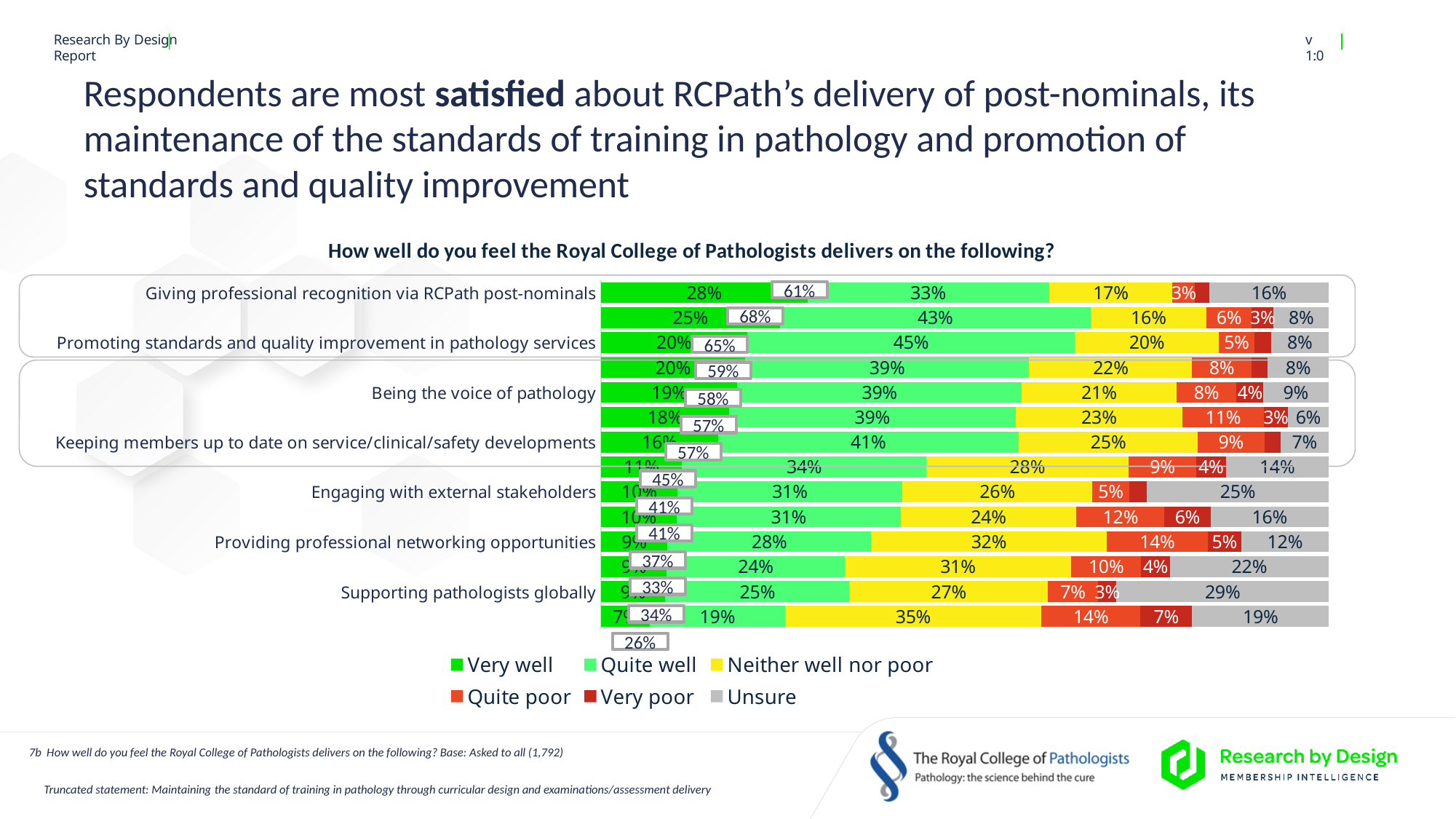
What is the 'Neither well nor poor' value for 'Being the voice of pathology'? 21% How many series does the legend list? 6 How many bars (statements) are plotted in the chart? 14 What kind of chart is shown on the slide? Stacked bar chart What is the 'Quite well' value for 'Promoting standards and quality improvement in pathology services'? 45% What is the 'Very well' value for 'Giving professional recognition via RCPath post-nominals'? 28% Which has the larger 'Unsure' value: 'Engaging with external stakeholders' or 'Giving professional recognition via RCPath post-nominals'? Engaging with external stakeholders What is the 'Quite well' value for 'Keeping members up to date on service/clinical/safety developments'? 41% Which statement has the highest 'Very well' value? Giving professional recognition via RCPath post-nominals What is the difference between the 'Quite well' values for 'Promoting standards and quality improvement in pathology services' and 'Supporting pathologists globally'? 20 percentage points What is the 'Unsure' value for 'Supporting pathologists globally'? 29% What is the 'Quite poor' value for 'Providing professional networking opportunities'? 14%